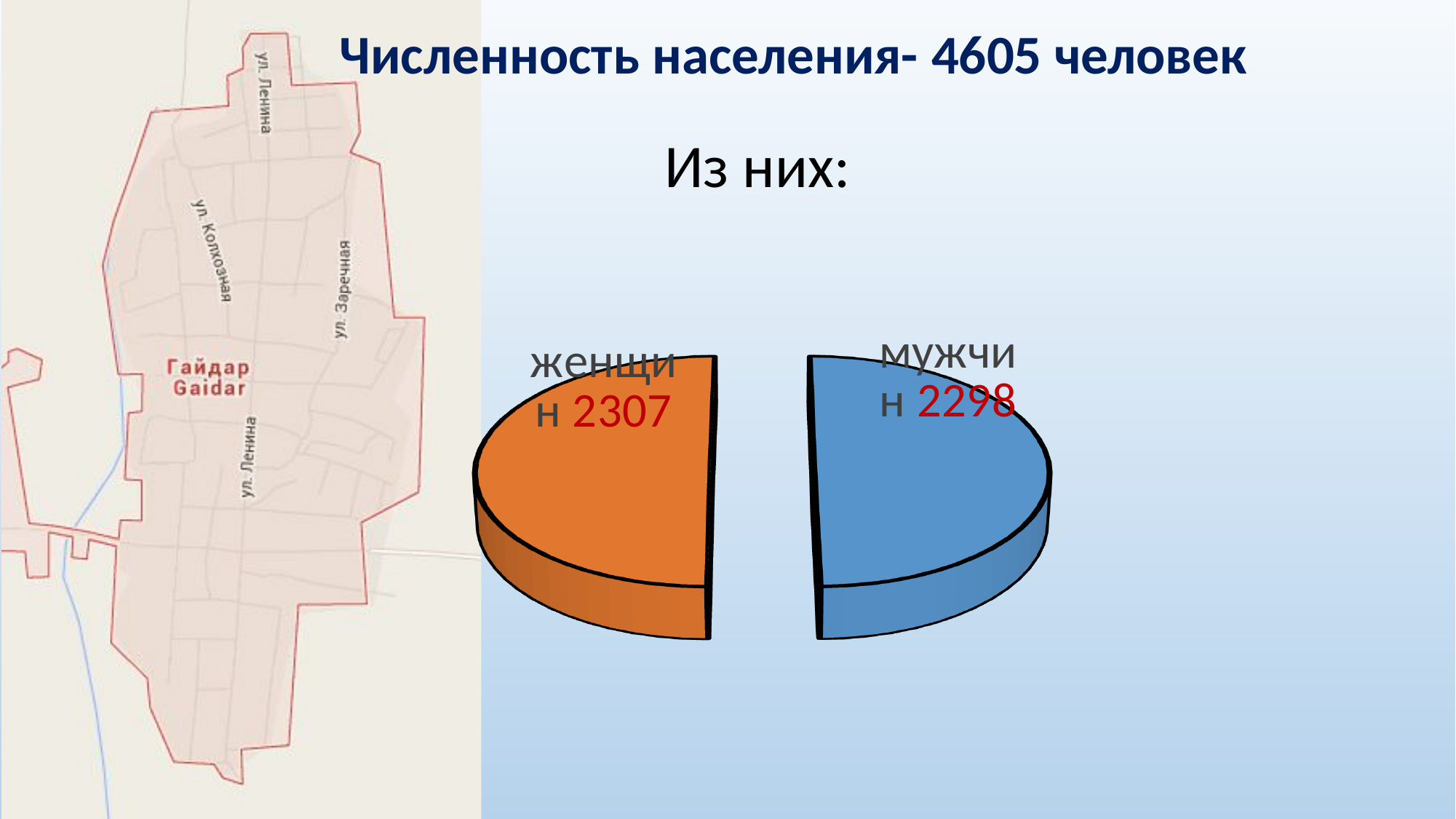
Which slice of the pie chart has the smallest value? мужчин What colour is the slice for мужчин in the pie chart? blue What is the total population stated in the slide title? 4605 человек What colour is the slice for женщин in the pie chart? orange Which slice of the pie chart has the largest value? женщин How many women (женщин) are shown in the pie chart? 2307 What is the difference between the number of women (2307) and men (2298) in the pie chart? 9 What kind of chart is shown on the slide? pie chart How many men (мужчин) are shown in the pie chart? 2298 How many slices does the pie chart have? 2 Which group has the larger value in the pie chart, женщин or мужчин? женщин